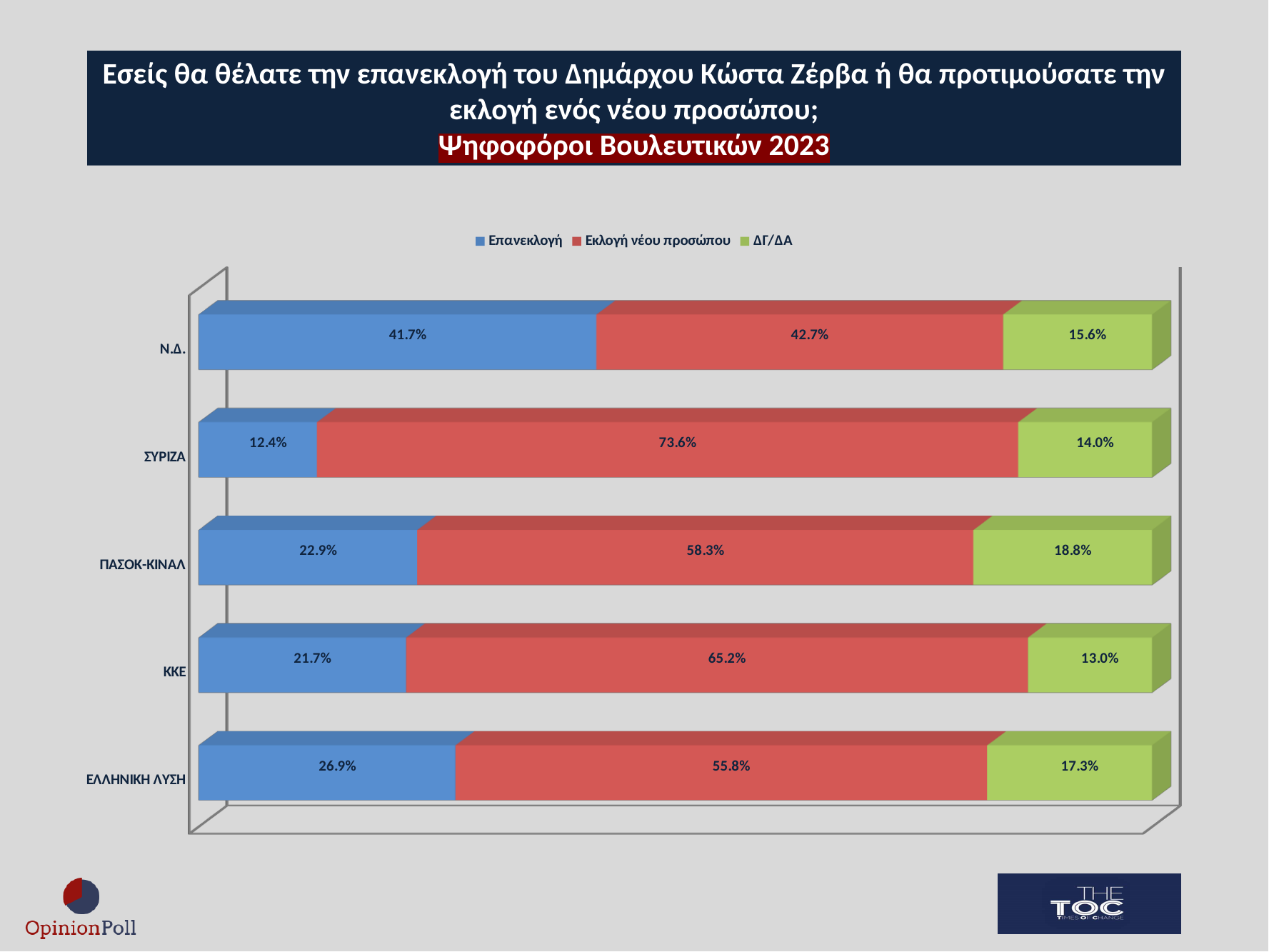
Which party's voters have the lowest ΔΓ/ΔΑ value? ΚΚΕ What is the ΔΓ/ΔΑ value for ΠΑΣΟΚ-ΚΙΝΑΛ? 18.8% Which party's voters have the highest Επανεκλογή value? Ν.Δ. How many parties (categories) are shown in the chart? 5 For ΚΚΕ voters, how much larger is Εκλογή νέου προσώπου than Επανεκλογή? 43.5 percentage points What is the Επανεκλογή value for ΕΛΛΗΝΙΚΗ ΛΥΣΗ? 26.9% How many series does the legend list? 3 What is the value for Εκλογή νέου προσώπου among ΣΥΡΙΖΑ voters? 73.6% What kind of chart is shown on the slide? Stacked bar chart What percentage of Ν.Δ. voters chose Επανεκλογή? 41.7% Which has the larger ΔΓ/ΔΑ value, ΚΚΕ or ΕΛΛΗΝΙΚΗ ΛΥΣΗ? ΕΛΛΗΝΙΚΗ ΛΥΣΗ Which party's voters have the lowest Επανεκλογή value? ΣΥΡΙΖΑ